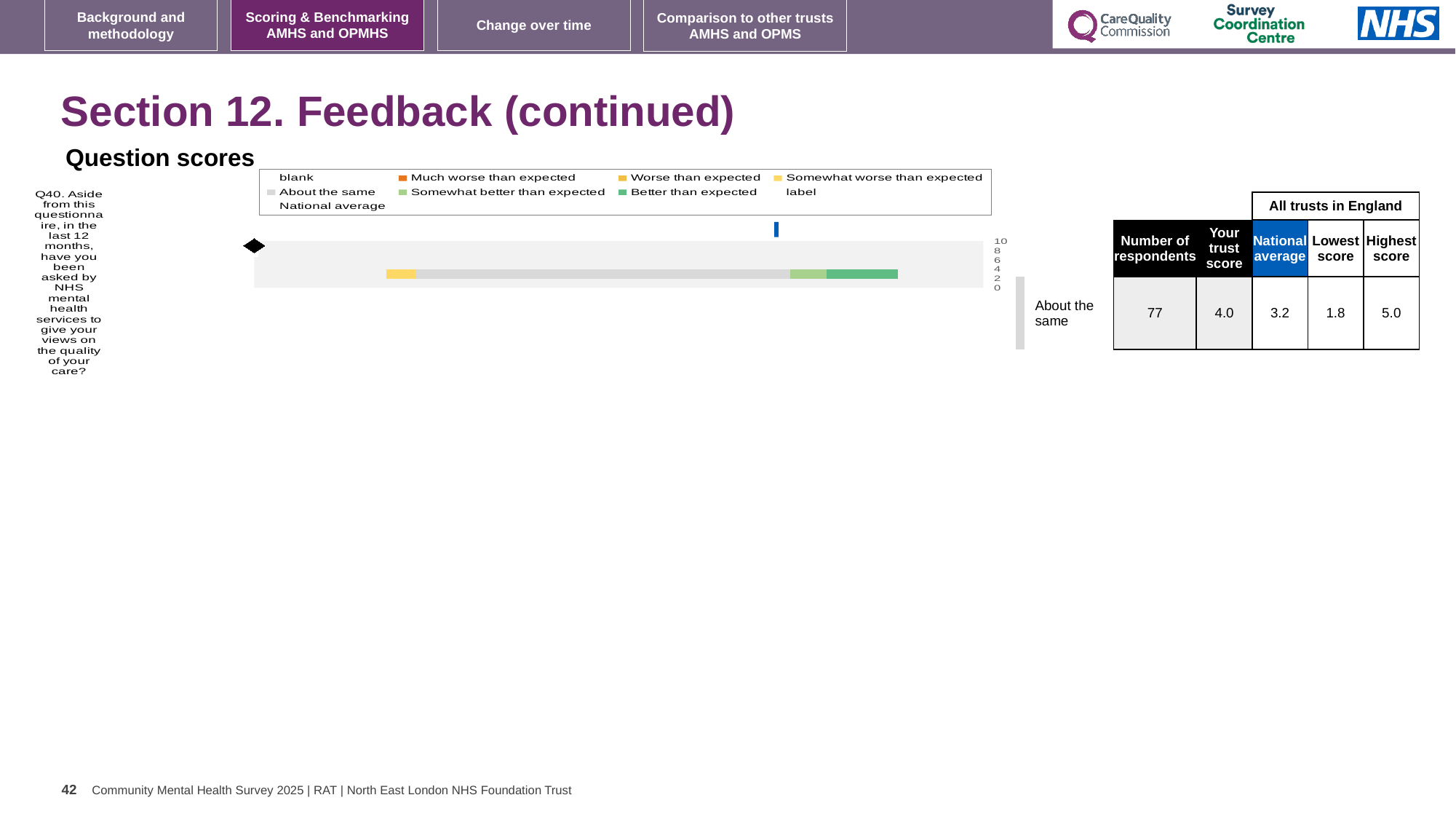
What kind of chart is used to show the question score for Q40? bar chart Which is larger for Q40: the trust's score or the national average? the trust's score What is the national average score for Q40 shown in the table beside the chart? 3.2 What is the lowest score among all trusts in England for Q40? 1.8 What is the highest score among all trusts in England for Q40? 5.0 Which legend entry is shown in dark green in the Question scores chart? Better than expected What is the difference between the trust's score and the national average for Q40? 0.8 How many questions are plotted in the Question scores chart? 1 How many respondents answered Q40? 77 Which rating band is the trust's score for Q40 placed in, according to the label next to the chart? About the same What is the trust's score for Q40 shown in the table beside the chart? 4.0 What is the difference between the highest and lowest scores among all trusts in England for Q40? 3.2